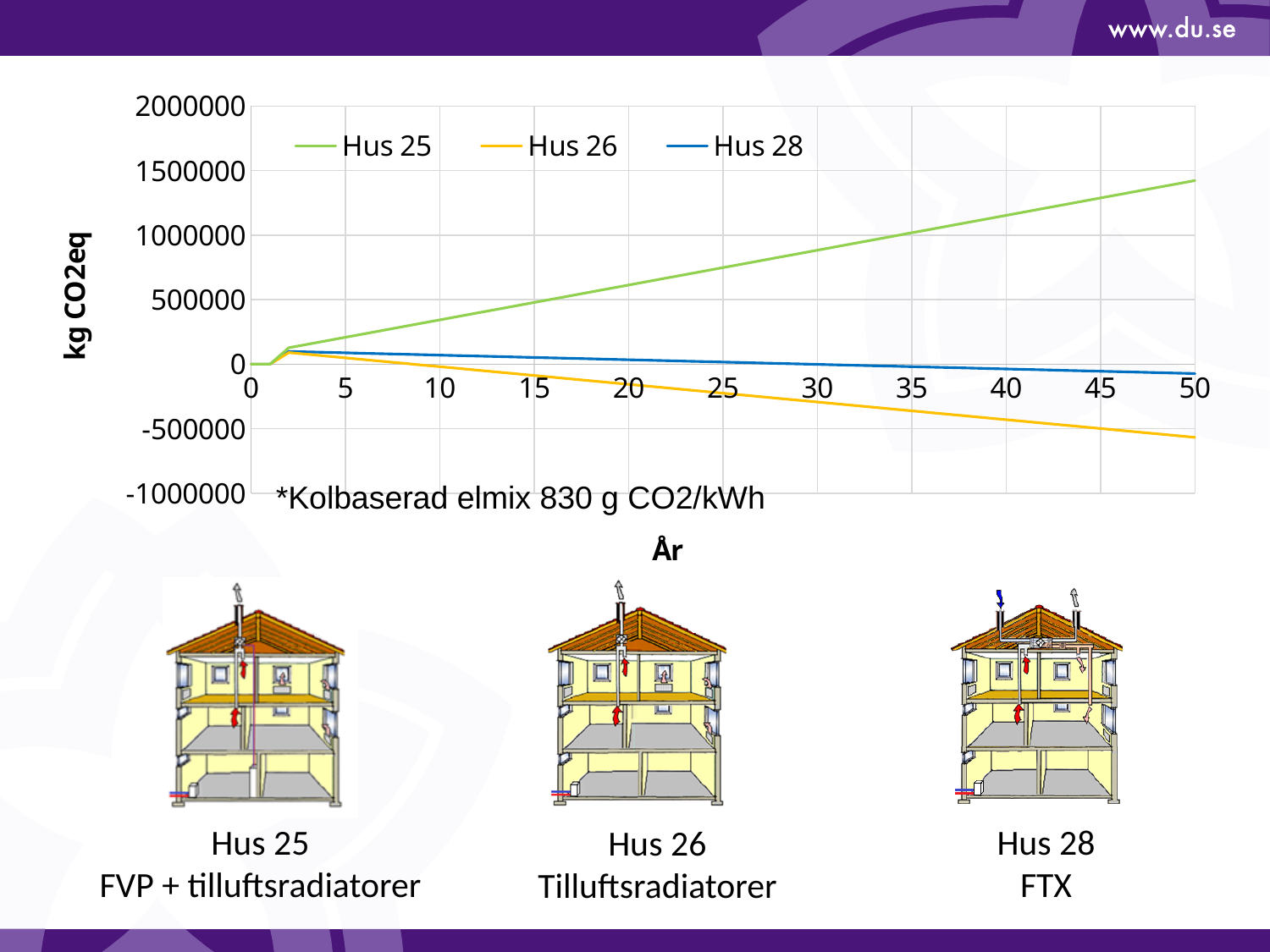
Which series has the lowest value at year 50? Hus 26 Does the Hus 26 line rise or fall as the years increase along the x axis? fall How many series does the chart legend list? 3 What is the label of the vertical axis of the chart? kg CO2eq Is the value for Hus 25 at year 50 greater or less than 1000000 kg CO2eq? greater Is the value for Hus 26 at year 50 greater or less than -500000 kg CO2eq? less Which series are listed in the chart legend? Hus 25, Hus 26, Hus 28 Does the Hus 25 line rise or fall as the years increase along the x axis? rise Which series has the highest value at year 50? Hus 25 Is the value for Hus 28 at year 50 greater or less than 0 kg CO2eq? less Does the Hus 28 line rise or fall after year 5 as the years increase along the x axis? fall What kind of chart is shown on the slide? line chart